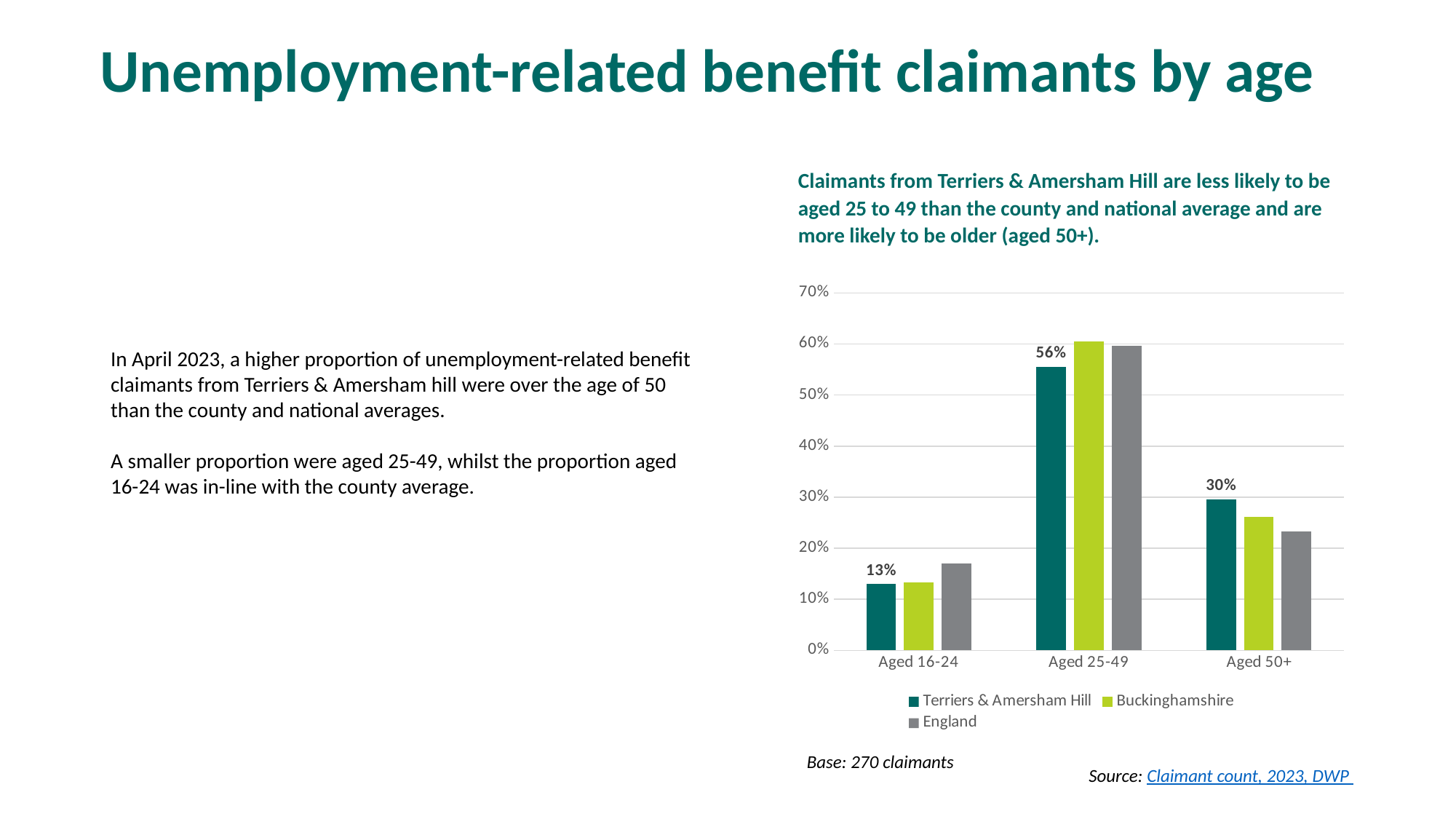
Which age group has the highest share of Terriers & Amersham Hill claimants? Aged 25-49 What percentage of Terriers & Amersham Hill claimants are aged 50+? 30% Which age group has the lowest share of Terriers & Amersham Hill claimants? Aged 16-24 How many series does the chart legend list? 3 For Aged 50+, which is larger: the Terriers & Amersham Hill bar or the England bar? Terriers & Amersham Hill What is the difference in percentage points between the Terriers & Amersham Hill values for Aged 25-49 and Aged 50+? 26 percentage points How many age groups are shown on the x axis of the chart? 3 What percentage of Terriers & Amersham Hill claimants are aged 25-49? 56% Is the England value for Aged 50+ greater or less than 30%? less For Aged 25-49, which is larger: the Terriers & Amersham Hill bar or the Buckinghamshire bar? Buckinghamshire Is the Buckinghamshire value for Aged 25-49 greater or less than 50%? greater What percentage of Terriers & Amersham Hill claimants are aged 16-24? 13%